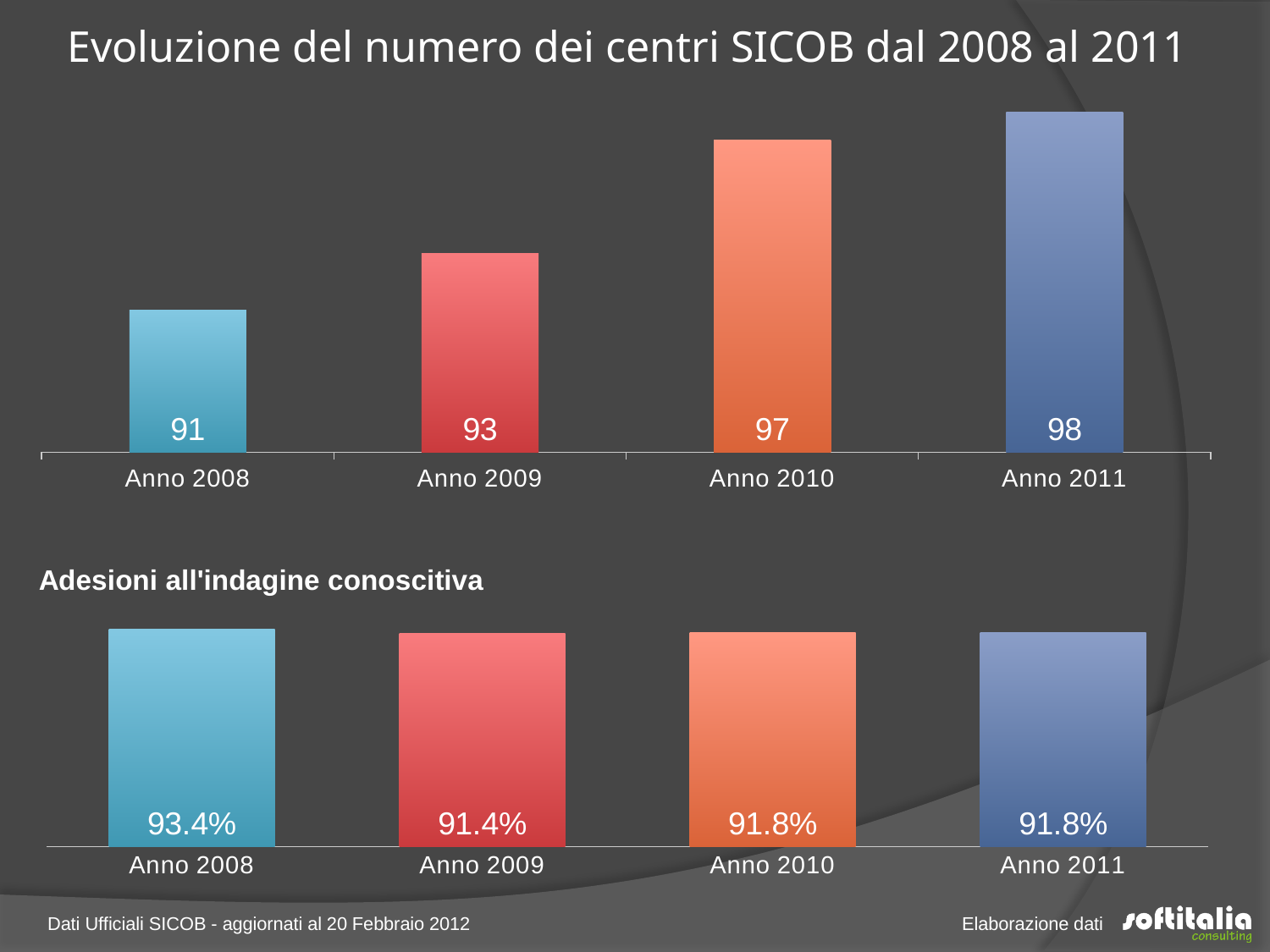
In the top chart (Evoluzione del numero dei centri SICOB dal 2008 al 2011), which year has the lowest value? Anno 2008 In the bottom chart (Adesioni all'indagine conoscitiva), what is the value for Anno 2010? 91.8% In the bottom chart (Adesioni all'indagine conoscitiva), which year has the lowest value? Anno 2009 What is the title of the top chart on the slide? Evoluzione del numero dei centri SICOB dal 2008 al 2011 In the top chart (Evoluzione del numero dei centri SICOB dal 2008 al 2011), which year has the highest value? Anno 2011 In the top chart (Evoluzione del numero dei centri SICOB dal 2008 al 2011), what is the value for Anno 2009? 93 In the top chart (Evoluzione del numero dei centri SICOB dal 2008 al 2011), how many years are shown? 4 In the top chart (Evoluzione del numero dei centri SICOB dal 2008 al 2011), what is the difference between the values for Anno 2011 and Anno 2008? 7 In the bottom chart (Adesioni all'indagine conoscitiva), what is the value for Anno 2008? 93.4% In the bottom chart (Adesioni all'indagine conoscitiva), what is the difference between the values for Anno 2008 and Anno 2009? 2.0% In the top chart (Evoluzione del numero dei centri SICOB dal 2008 al 2011), do the values rise or fall from Anno 2008 to Anno 2011? rise What kind of chart is the top chart (Evoluzione del numero dei centri SICOB dal 2008 al 2011)? bar chart